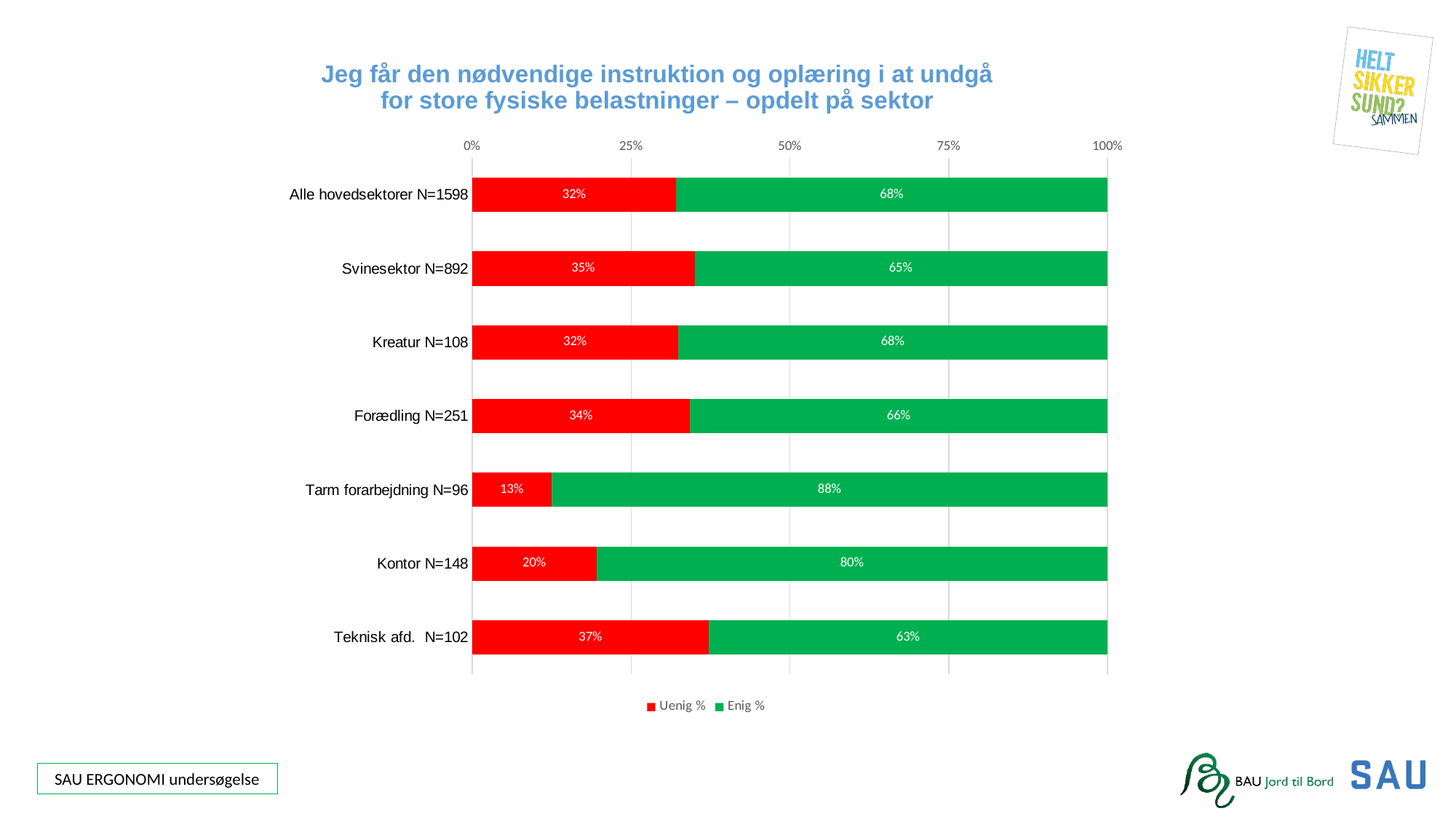
What is the Enig % value for Tarm forarbejdning N=96? 88% Which category has the highest Uenig % value? Teknisk afd. N=102 What kind of chart is shown on the slide? Stacked bar chart Which is larger, the Uenig % value for Forædling N=251 or for Kreatur N=108? Forædling N=251 Which colour represents Enig % in the chart? Green How many series does the legend list? 2 Which category has the lowest Enig % value? Teknisk afd. N=102 What is the Uenig % value for Svinesektor N=892? 35% What is the Enig % value for Kontor N=148? 80% How many categories are shown on the chart? 7 What is the difference between the Enig % values for Tarm forarbejdning N=96 and Teknisk afd. N=102? 25% Is the Enig % value for Kontor N=148 greater or less than 75%? greater